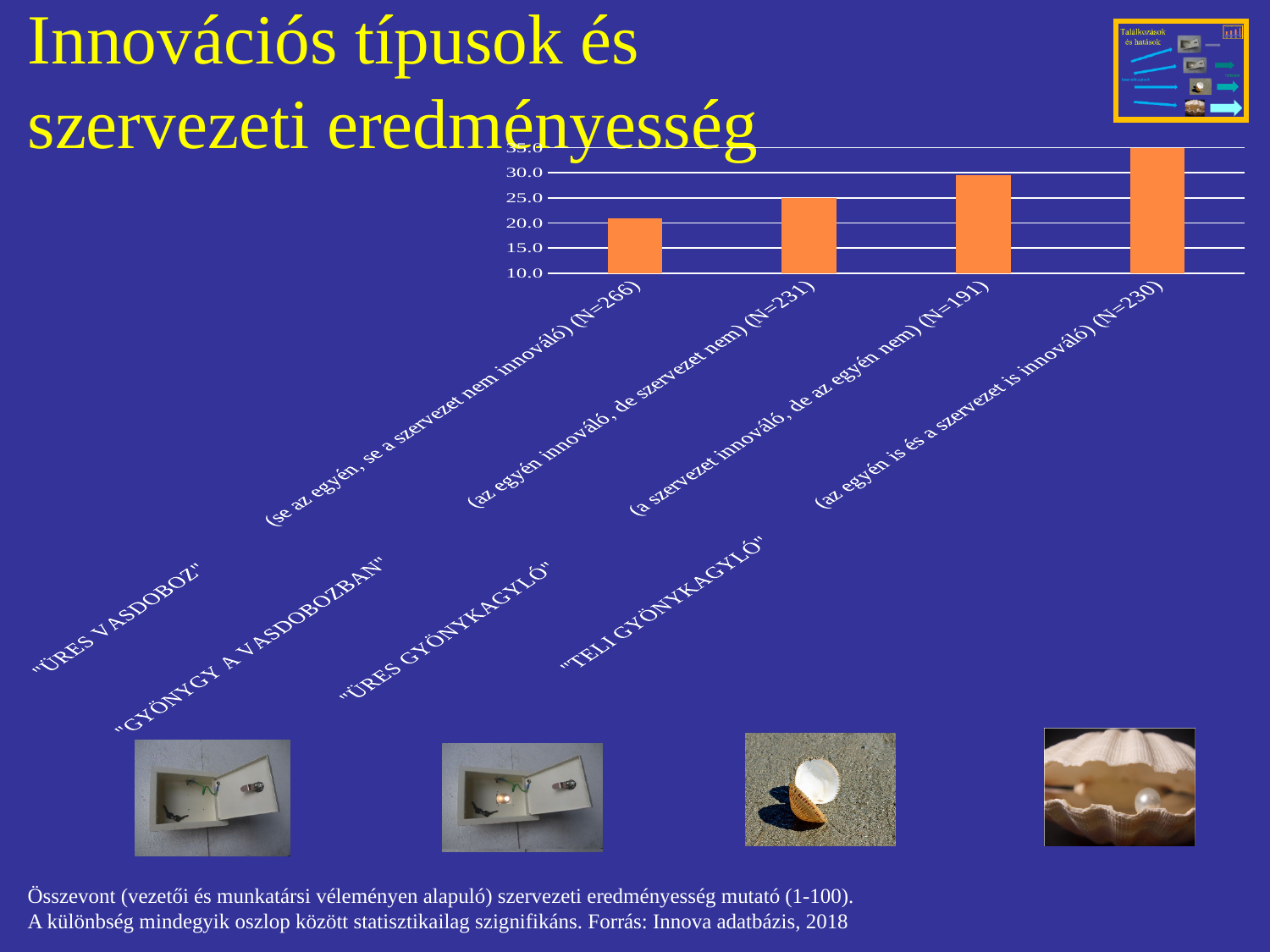
What kind of chart is shown on the slide? bar chart Is the value for "GYÖNYGY A VASDOBOZBAN" greater or less than 20? greater Is the value for "TELI GYÖNYKAGYLÓ" greater or less than 30? greater Which category has the highest bar? "TELI GYÖNYKAGYLÓ" (az egyén is és a szervezet is innováló) (N=230) Do the bar values rise or fall from left to right across the categories? rise Is the value for "GYÖNYGY A VASDOBOZBAN" greater or less than 30? less What is the sample size (N) shown for the "ÜRES GYÖNYKAGYLÓ" category? N=191 Which category has the lowest bar? "ÜRES VASDOBOZ" (se az egyén, se a szervezet nem innováló) (N=266) How many bars (categories) does the chart show? 4 Which is larger, the value for "ÜRES VASDOBOZ" or the value for "TELI GYÖNYKAGYLÓ"? "TELI GYÖNYKAGYLÓ"